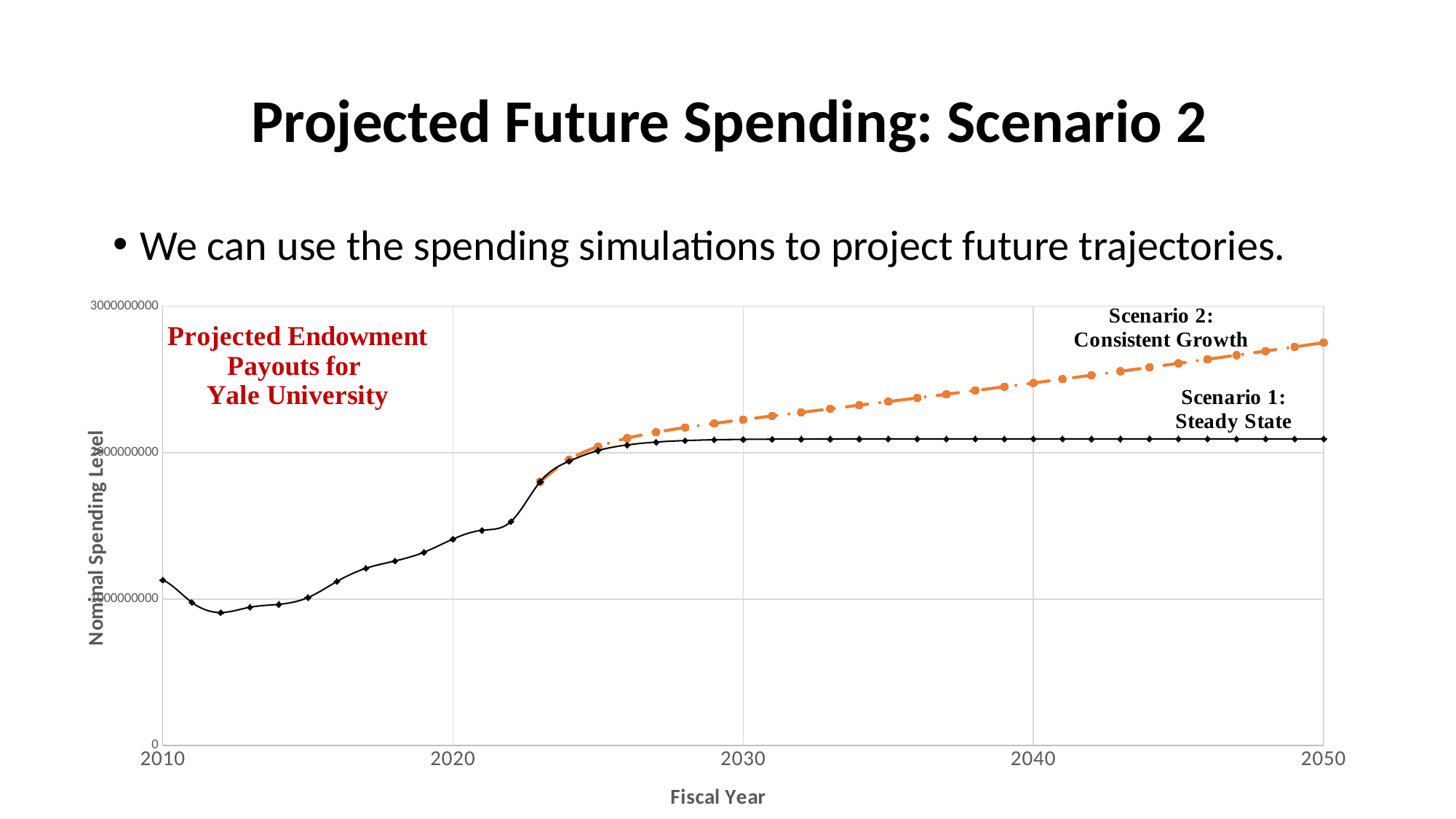
Is the spending level in 2010 greater or less than 2000000000? less How many series are plotted on the chart? 2 How many year labels are shown on the x axis? 5 Is the spending level in 2020 greater or less than 1000000000? greater Does the spending level rise or fall between 2010 and 2012? Fall Is the spending level in 2020 greater or less than 2000000000? less In 2050, which scenario has the higher spending level, Scenario 1: Steady State or Scenario 2: Consistent Growth? Scenario 2: Consistent Growth What kind of chart is shown on the slide? Line chart What is the label of the x axis? Fiscal Year Does the Scenario 2: Consistent Growth line rise or fall between 2030 and 2050? Rise What is the title of the chart? Projected Endowment Payouts for Yale University